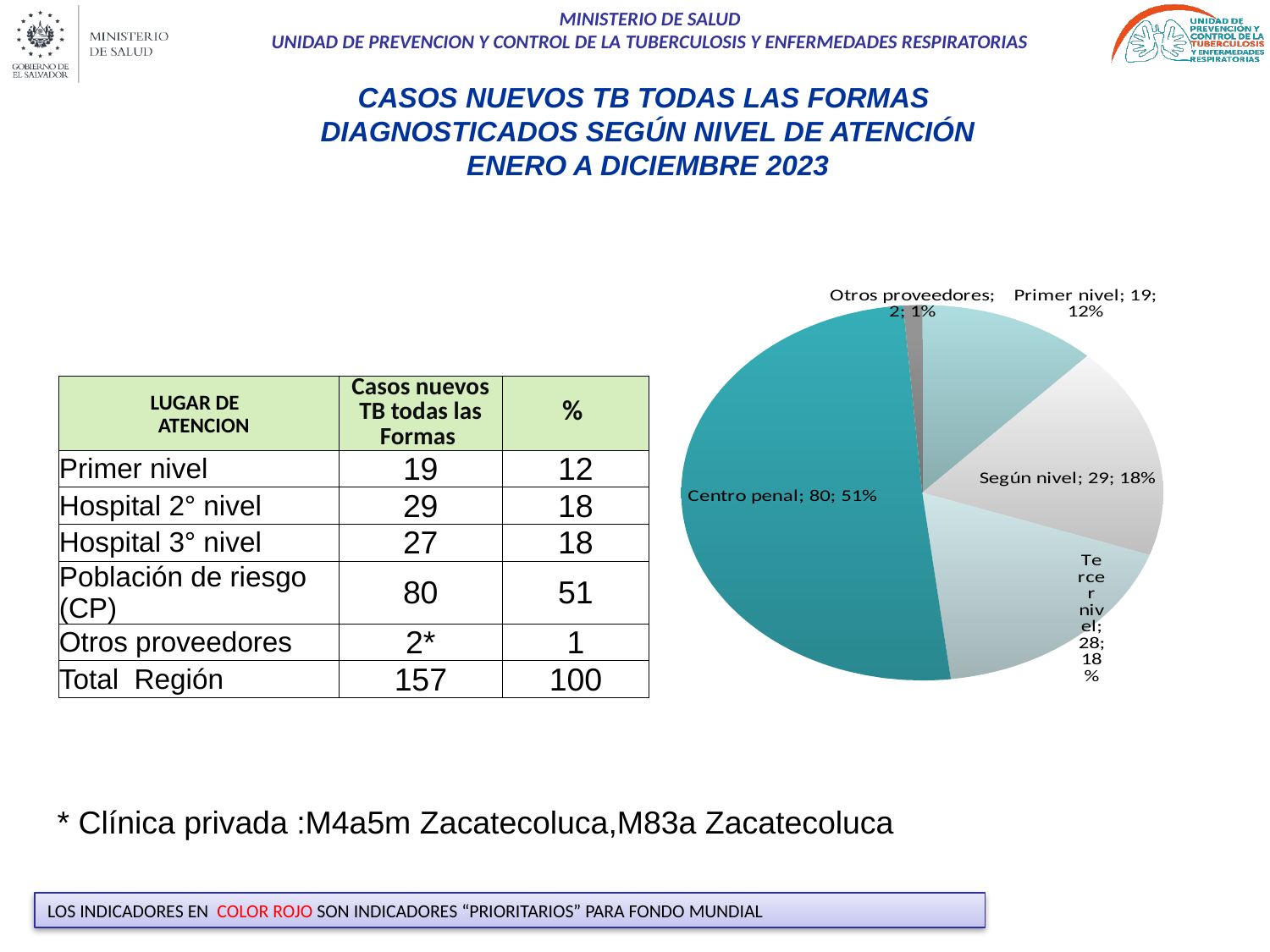
Which slice of the pie chart is the smallest? Otros proveedores How many slices does the pie chart have? 5 What percentage share does Centro penal have in the pie chart? 51% What value is shown for Centro penal in the pie chart? 80 What is the difference between the Centro penal value and the Según nivel value in the pie chart? 51 What value is shown for Primer nivel in the pie chart? 19 Which is larger in the pie chart, Primer nivel or Tercer nivel? Tercer nivel What value is shown for Según nivel in the pie chart? 29 What value is shown for Otros proveedores in the pie chart? 2 Which slice of the pie chart is the largest? Centro penal What kind of chart is shown on the slide? pie chart What percentage share does Primer nivel have in the pie chart? 12%